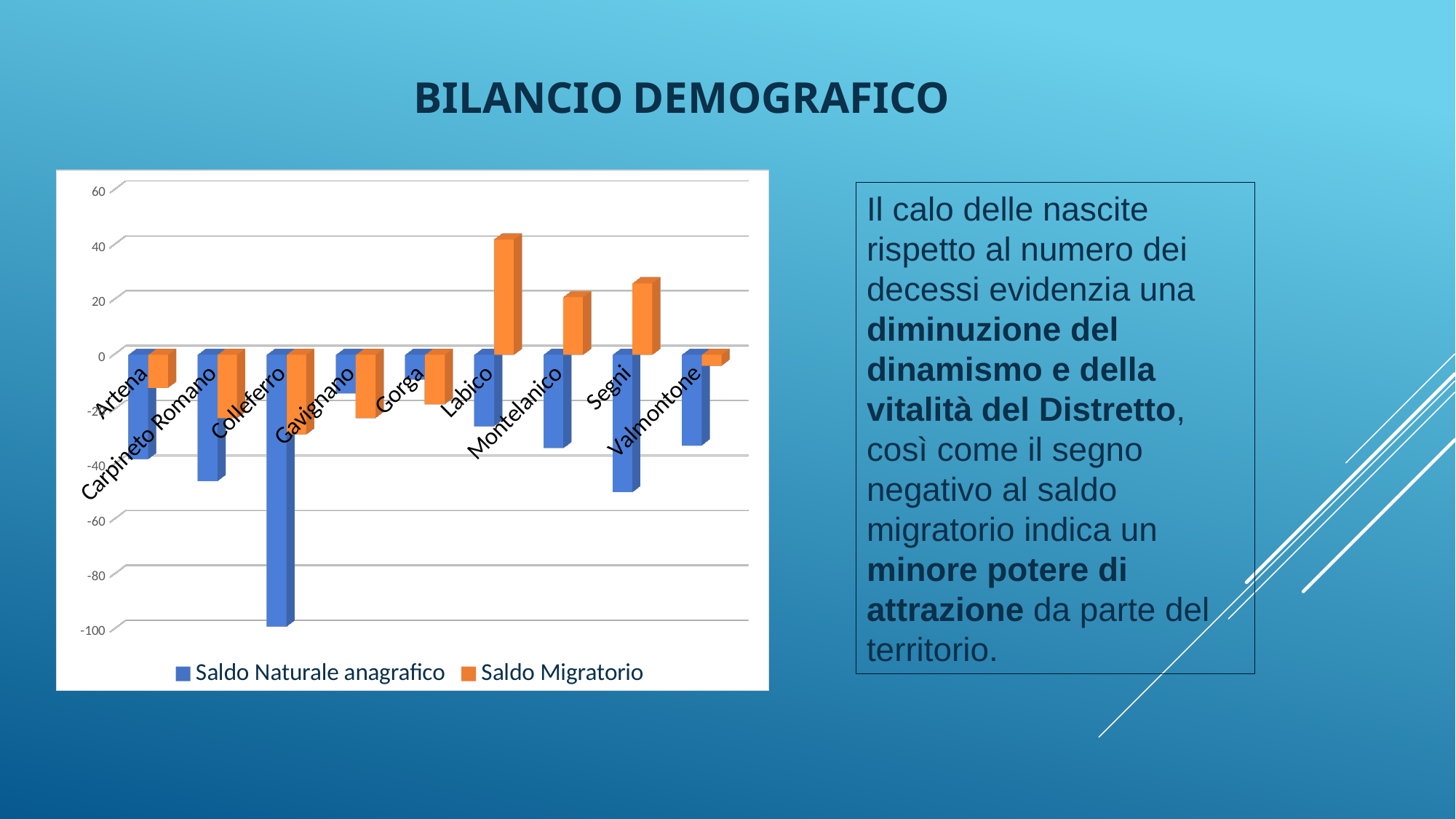
Which has the larger Saldo Migratorio value, Labico or Montelanico? Labico Is the Saldo Naturale anagrafico value for Segni greater or less than -40? less Which municipality has the highest Saldo Migratorio value? Labico What kind of chart is shown on the slide? Bar chart Is the Saldo Naturale anagrafico value for Colleferro greater or less than -80? less Is the Saldo Migratorio value for Labico greater or less than 20? greater How many municipalities have a positive Saldo Migratorio value? 3 What are the two series named in the chart legend? Saldo Naturale anagrafico and Saldo Migratorio Which has the larger Saldo Naturale anagrafico value, Artena or Segni? Artena How many series does the chart legend list? 2 How many municipalities (categories) are shown on the x axis of the chart? 9 Which municipality has the lowest Saldo Naturale anagrafico value? Colleferro